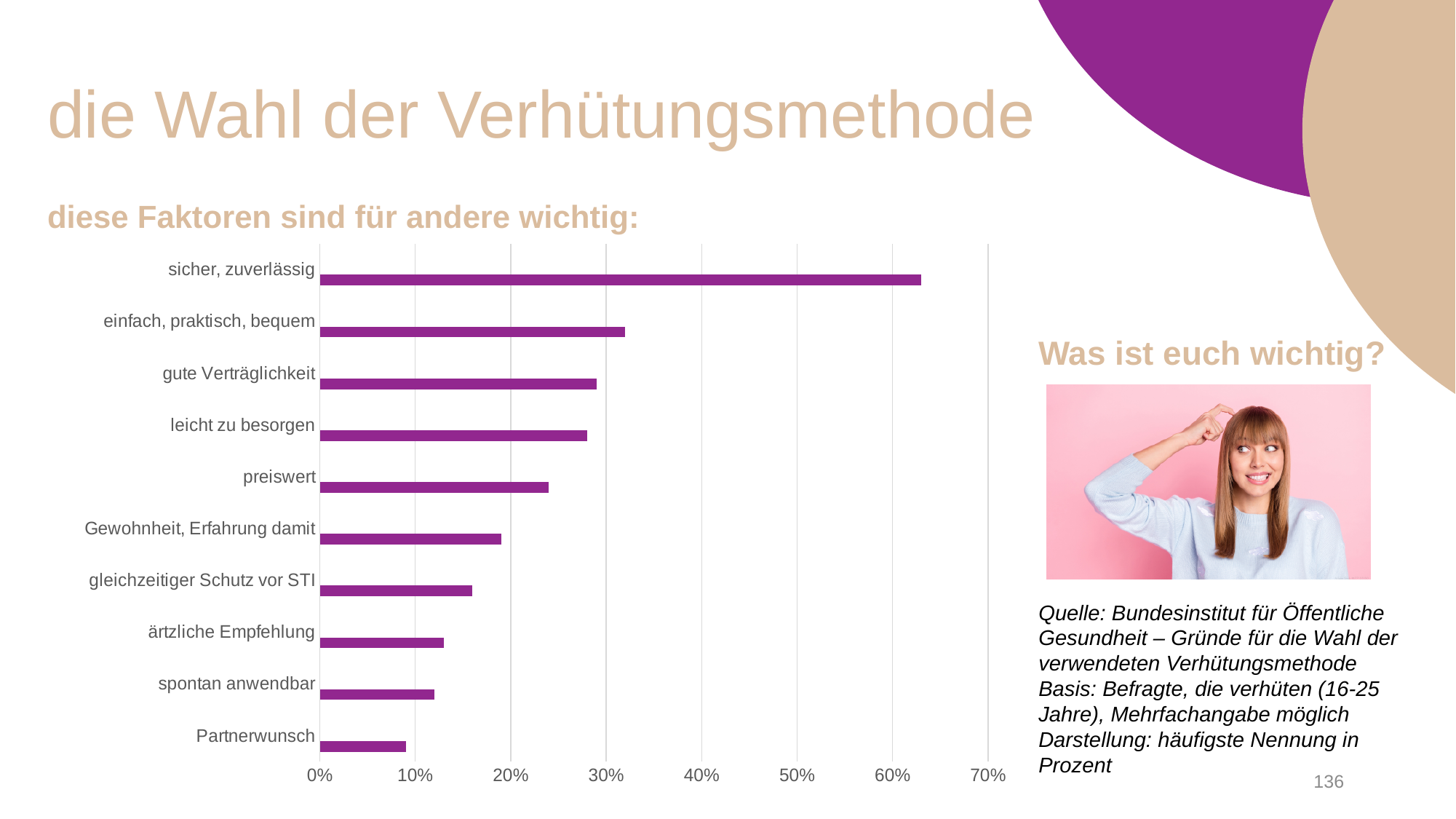
Which category has the lowest value? Partnerwunsch Which category has the highest value? sicher, zuverlässig What is the highest value shown on the chart's x axis? 70% How many categories does the chart show? 10 Is the value for "Partnerwunsch" greater or less than 10%? less Is the value for "gleichzeitiger Schutz vor STI" greater or less than 20%? less Is the value for "sicher, zuverlässig" greater or less than 60%? greater Which is larger, the value for "preiswert" or the value for "Gewohnheit, Erfahrung damit"? preiswert What kind of chart is shown on the slide? bar chart Which is larger, the value for "ärztliche Empfehlung" or the value for "gute Verträglichkeit"? gute Verträglichkeit